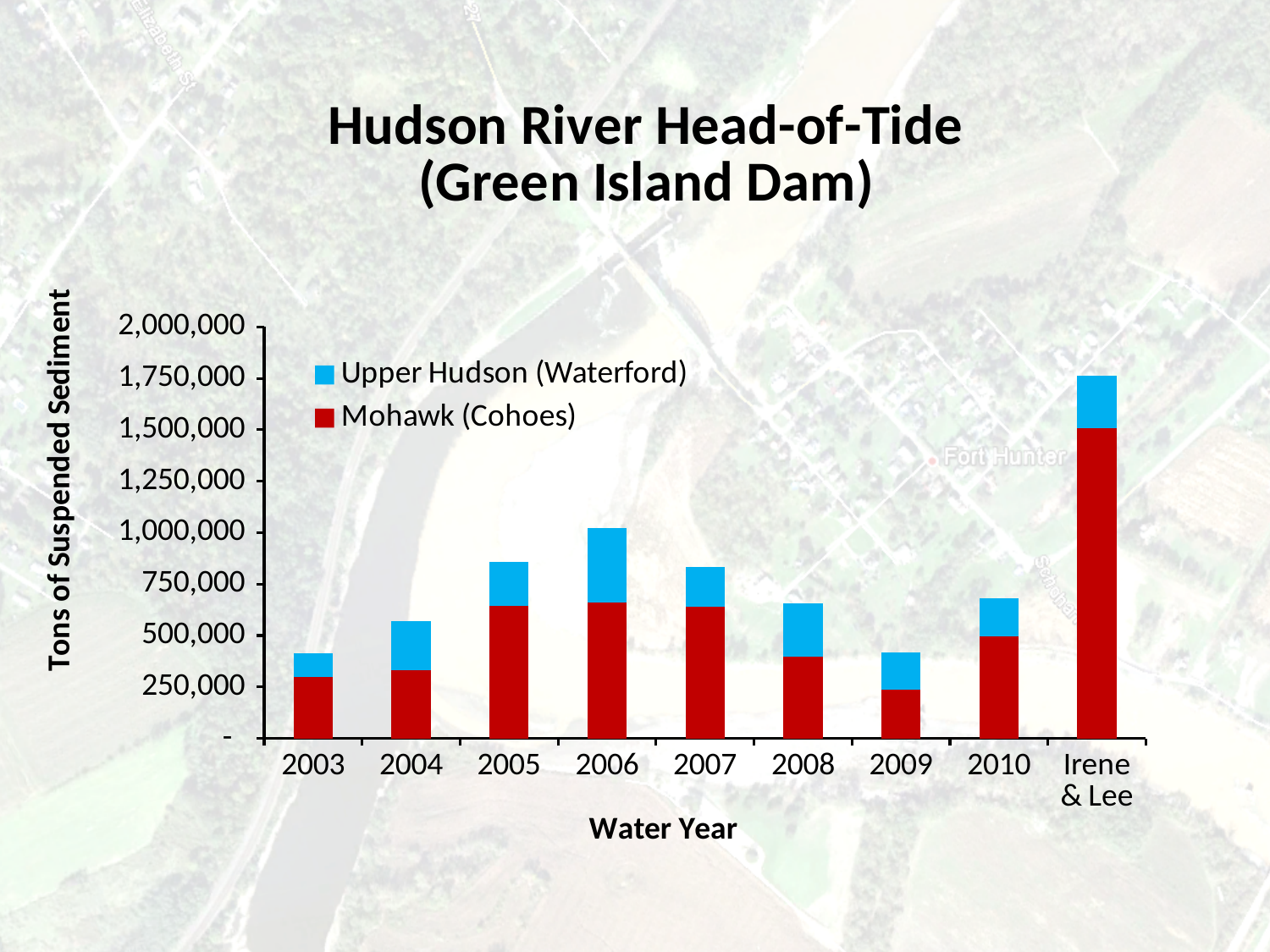
Which has the larger total tons of suspended sediment, 2006 or 2007? 2006 How many categories are shown along the x axis of the chart? 9 Is the total value for Irene & Lee greater or less than 1,500,000? greater Is the total value for 2009 greater or less than 500,000? less How many series does the chart's legend list? 2 Do the total values rise or fall from 2006 to 2009? fall Which water year category has the highest total tons of suspended sediment? Irene & Lee What is the label on the y axis of the chart? Tons of Suspended Sediment What kind of chart is shown on the slide? Stacked bar chart Is the Mohawk (Cohoes) value for Irene & Lee greater or less than 1,250,000? greater Which series is shown in red in the chart? Mohawk (Cohoes)